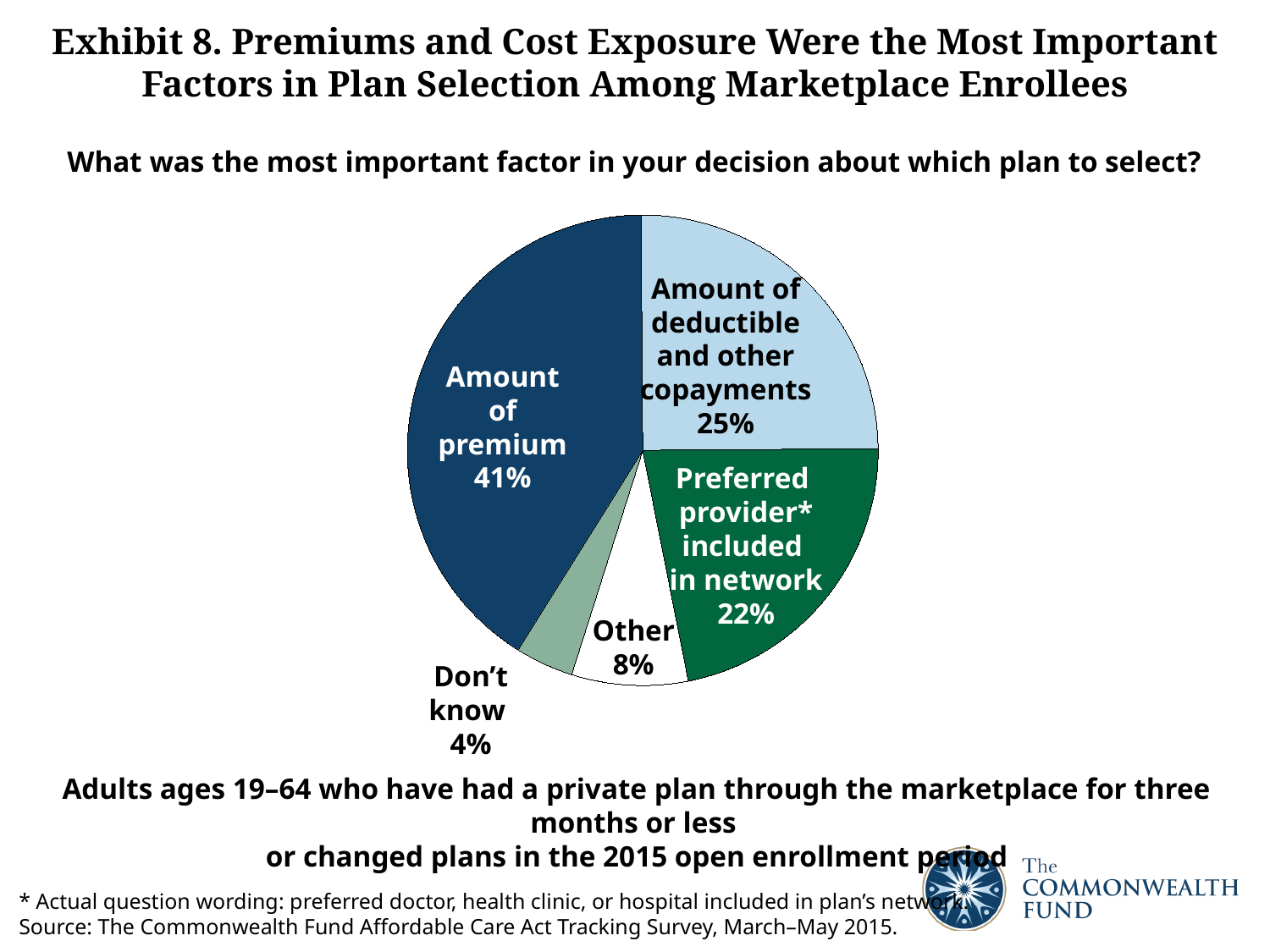
What percentage is shown for amount of deductible and other copayments? 25% What share of respondents said amount of premium was the most important factor? 41% How many slices does the pie chart have? 5 What share of the pie is labelled Other? 8% What percentage of respondents answered Don't know? 4% Which factor has the largest slice of the pie? Amount of premium Which is larger, the share for amount of deductible and other copayments or the share for Other? Amount of deductible and other copayments What is the difference in percentage points between amount of premium and preferred provider included in network? 19 What kind of chart is shown on the slide? pie chart What percentage of respondents chose preferred provider included in network? 22% Which category has the smallest slice of the pie? Don't know What question is the pie chart answering, as stated above the chart? What was the most important factor in your decision about which plan to select?